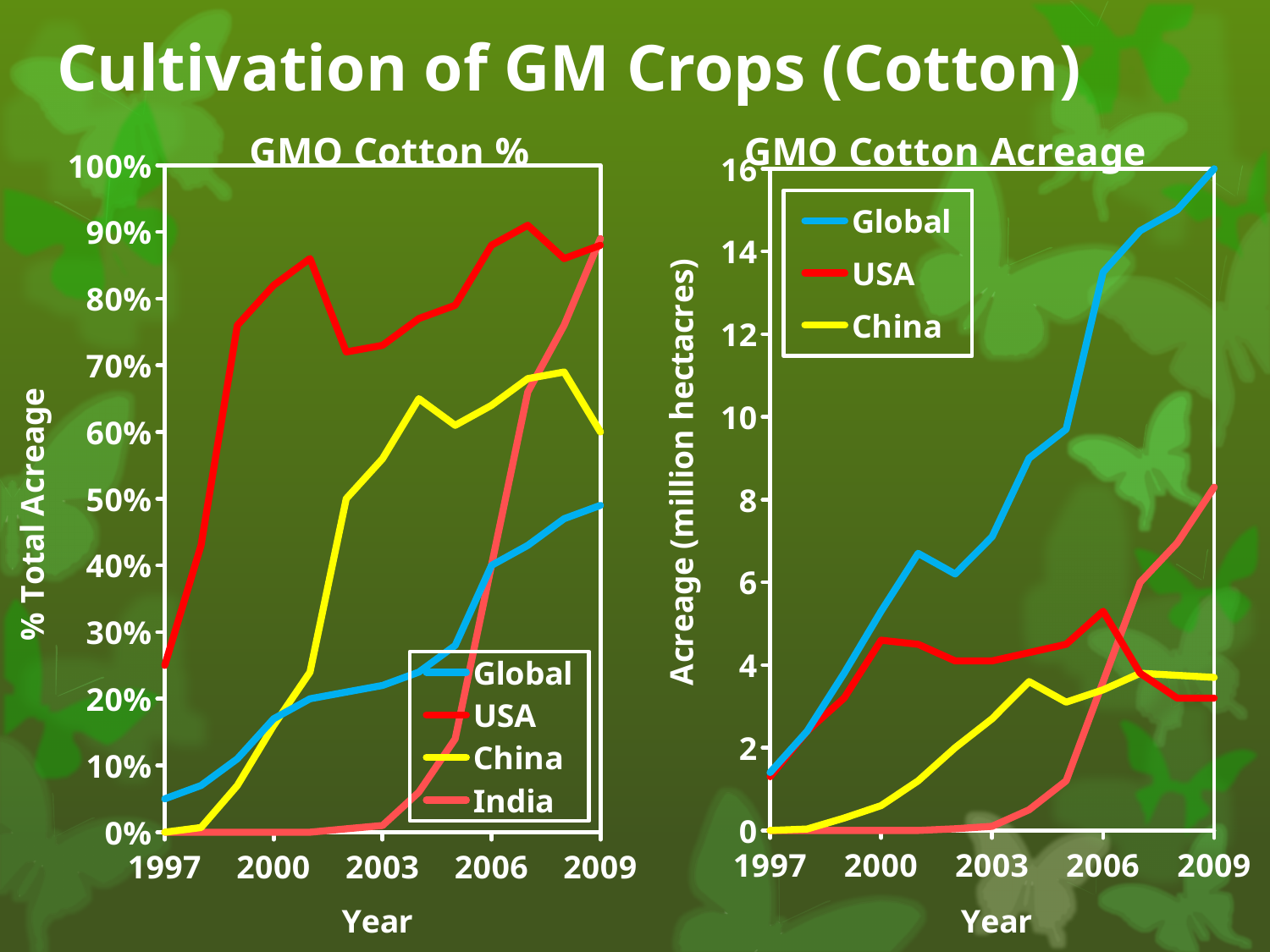
In the GMO Cotton % chart, is the value for China in 2004 greater or less than 60%? greater In the GMO Cotton % chart, is the value for USA in 2009 greater or less than 80%? greater What kind of chart is the GMO Cotton % chart? line chart How many series does the legend of the GMO Cotton Acreage chart list? 3 In the GMO Cotton Acreage chart, is the value for USA in 2006 greater or less than 4? greater What is the y-axis label of the GMO Cotton Acreage chart? Acreage (million hectacres) How many series does the legend of the GMO Cotton % chart list? 4 In the GMO Cotton % chart, which series has the lowest value in 2003? India In the GMO Cotton % chart, which series has the highest value in 2003? USA In the GMO Cotton Acreage chart, which series has the highest value in 2009? Global